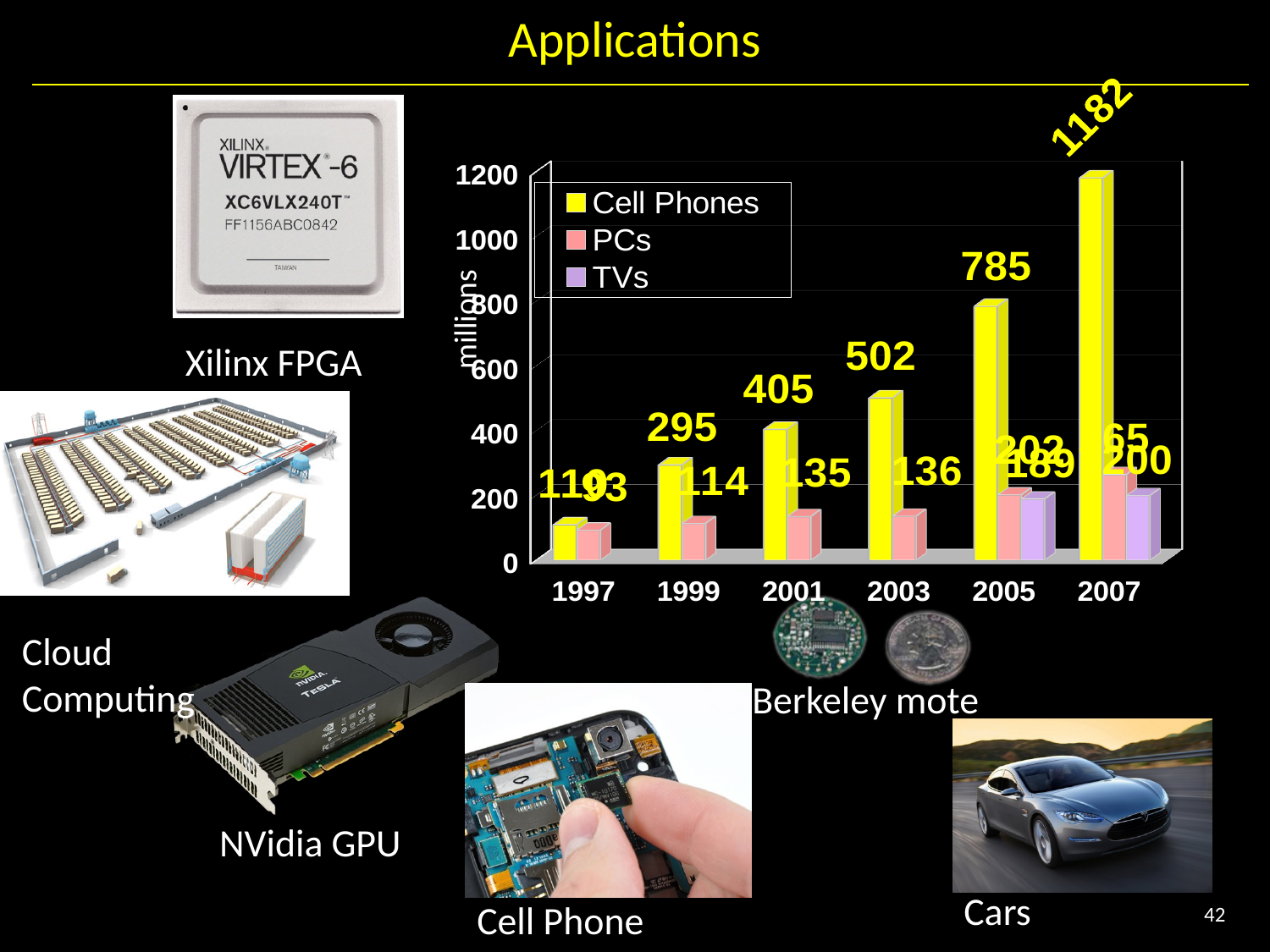
Which is larger in 2003, the Cell Phones value or the PCs value? Cell Phones Do the Cell Phones values rise or fall from 1997 to 2007? rise Is the value for PCs in 2007 greater or less than 200? greater How many series does the legend list? 3 What is the value for Cell Phones in 2005? 785 What is the value for Cell Phones in 2007? 1182 What is the value for PCs in 2001? 135 What is the difference between the Cell Phones values for 2007 and 2005? 397 In which year is the Cell Phones value lowest? 1997 In which year is the Cell Phones value highest? 2007 What is the value for Cell Phones in 1999? 295 How many years are shown on the x axis? 6